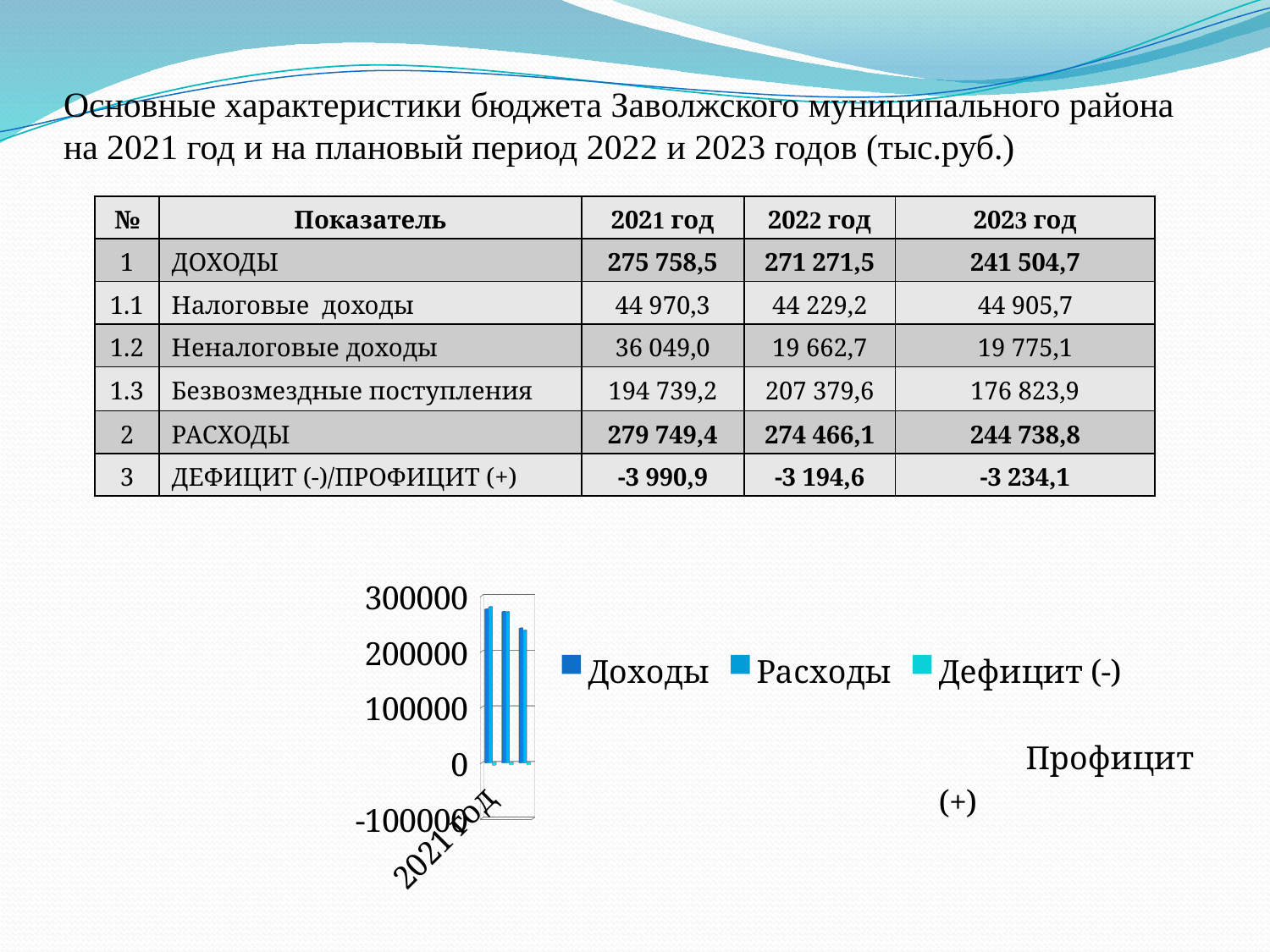
How many series does the chart legend list? 3 Is the value for Доходы in 2021 год greater or less than 200000? greater Is the value for Дефицит (-) in 2021 год greater or less than 100000? less What kind of chart is shown at the bottom of the slide? bar chart What is the first series named in the chart legend? Доходы What is the second series named in the chart legend? Расходы What is the lowest value shown on the chart's vertical axis? -100000 Is the value for Расходы in 2021 год greater or less than 300000? less Do the Доходы bars rise or fall from left to right along the x axis? fall